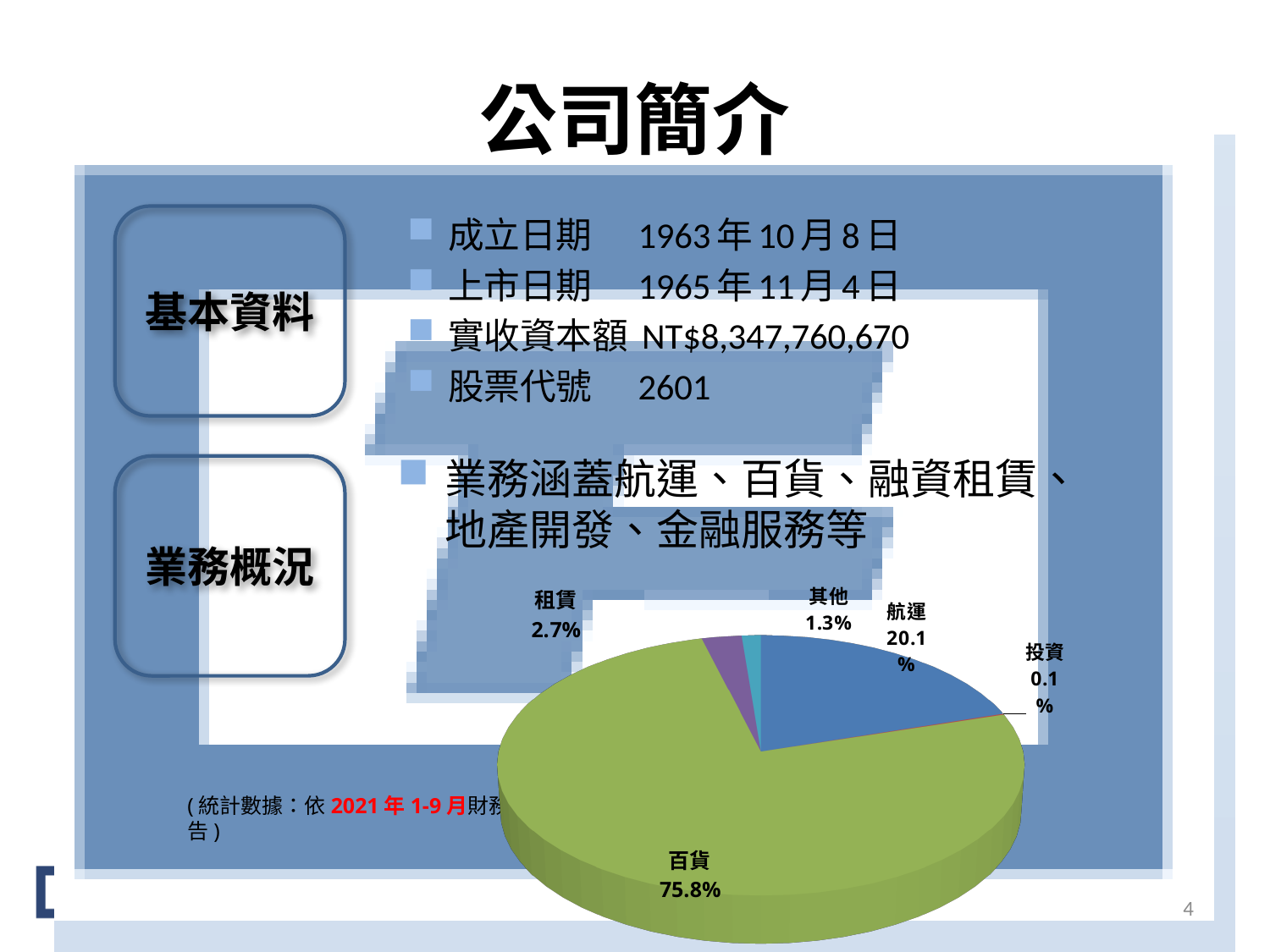
How many slices does the pie chart have? 5 Which category has the largest slice of the pie? 百貨 What is the difference in percentage points between 百貨 and 航運? 55.7 What colour is the 百貨 slice of the pie? green What share of the pie does 其他 account for? 1.3% What share of the pie does 百貨 account for? 75.8% What share of the pie does 租賃 account for? 2.7% What share of the pie does 航運 account for? 20.1% What share of the pie does 投資 account for? 0.1% What kind of chart is shown on the slide? pie chart Which category has the smallest slice of the pie? 投資 Which is larger, the share for 租賃 or the share for 其他? 租賃